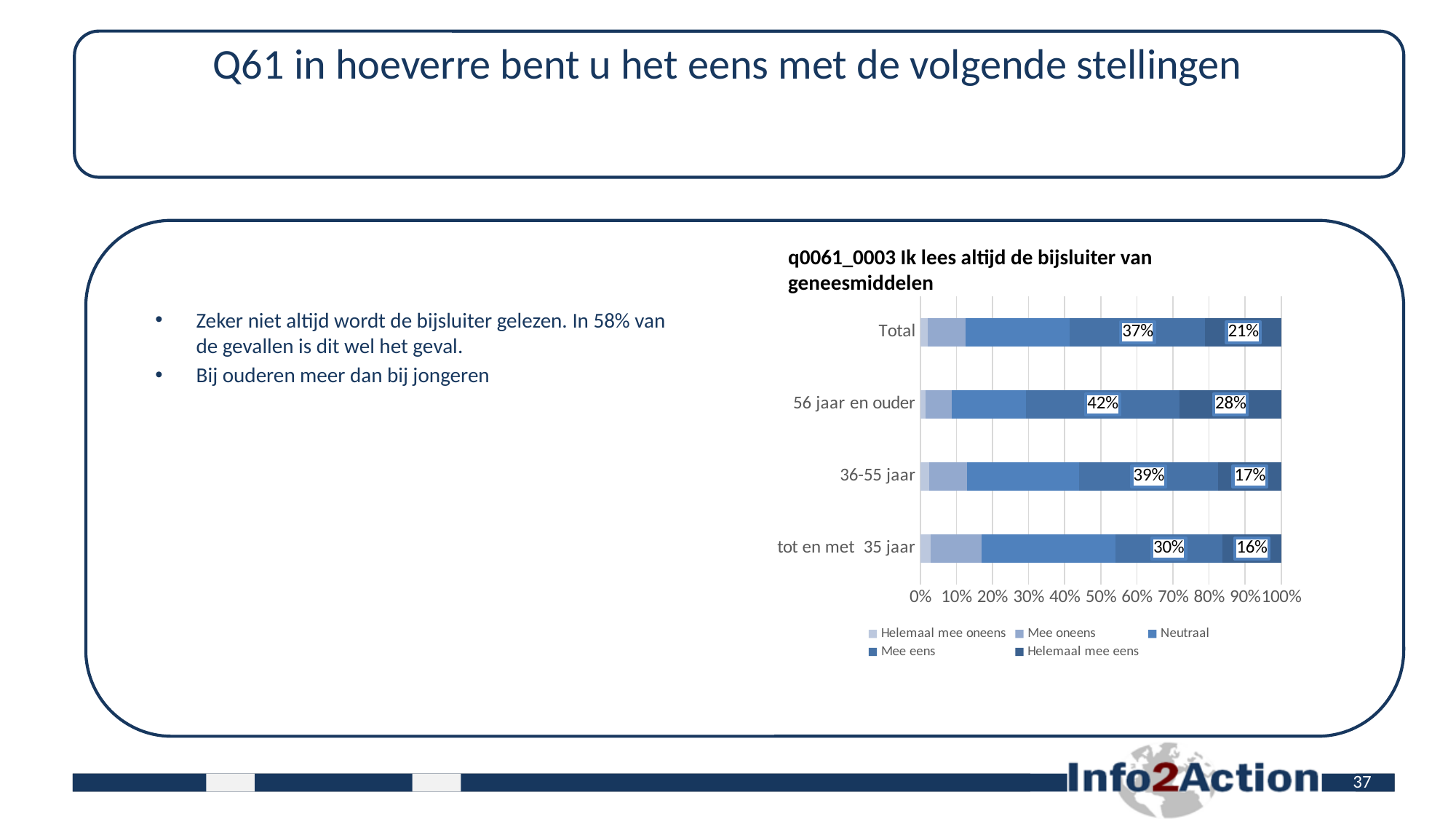
What is the value for "Mee eens" for the "56 jaar en ouder" category? 42% How many series does the legend list? 5 What is the value for "Helemaal mee eens" for the "Total" category? 21% What is the difference between the "Mee eens" values for "56 jaar en ouder" and "Total"? 5 percentage points What is the value for "Helemaal mee eens" for the "36-55 jaar" category? 17% What is the value for "Mee eens" for the "tot en met 35 jaar" category? 30% Which is larger: the "Helemaal mee eens" value for "56 jaar en ouder" or for "36-55 jaar"? 56 jaar en ouder How many categories are shown on the chart? 4 What kind of chart is shown on the slide? Stacked bar chart Which category has the lowest value for "Helemaal mee eens"? tot en met 35 jaar What is the title of the chart? q0061_0003 Ik lees altijd de bijsluiter van geneesmiddelen Which category has the highest value for "Mee eens"? 56 jaar en ouder